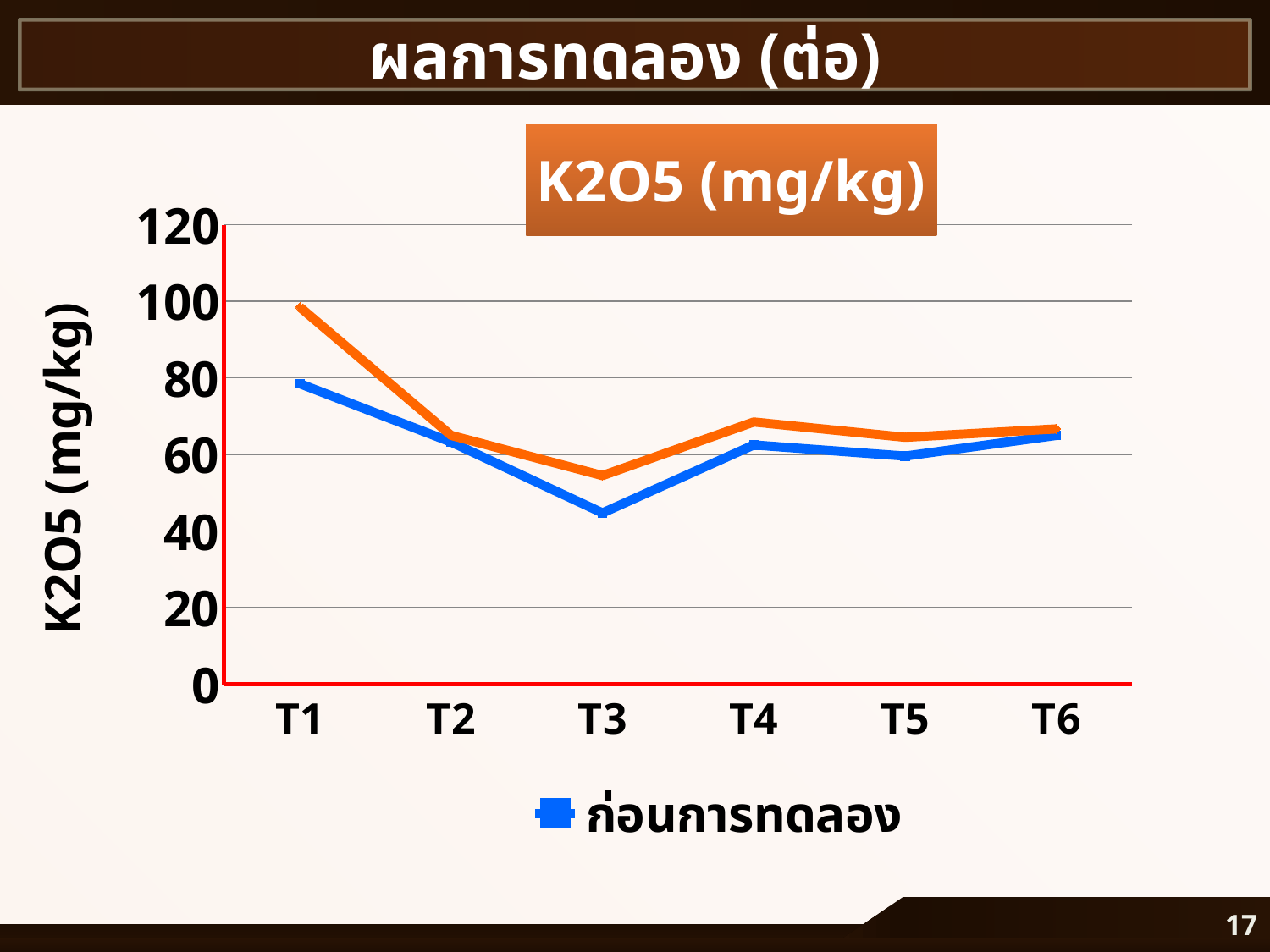
Do the values of the ก่อนการทดลอง (blue) line rise or fall from T1 to T3? fall What kind of chart is shown on the slide? line chart Is the ก่อนการทดลอง (blue) value at T1 greater or less than 60? greater Is the orange line's value at T1 greater or less than 80? greater How many series does the chart's legend list? 1 At T1, which line has the larger value, the orange line or the blue ก่อนการทดลอง line? the orange line Which category has the highest value for the ก่อนการทดลอง (blue) line? T1 Is the ก่อนการทดลอง (blue) value at T3 greater or less than 60? less Which category has the lowest value for the ก่อนการทดลอง (blue) line? T3 Which category has the lowest value for the orange line? T3 What is the title of the chart? K2O5 (mg/kg) How many categories are shown on the x axis of the chart? 6